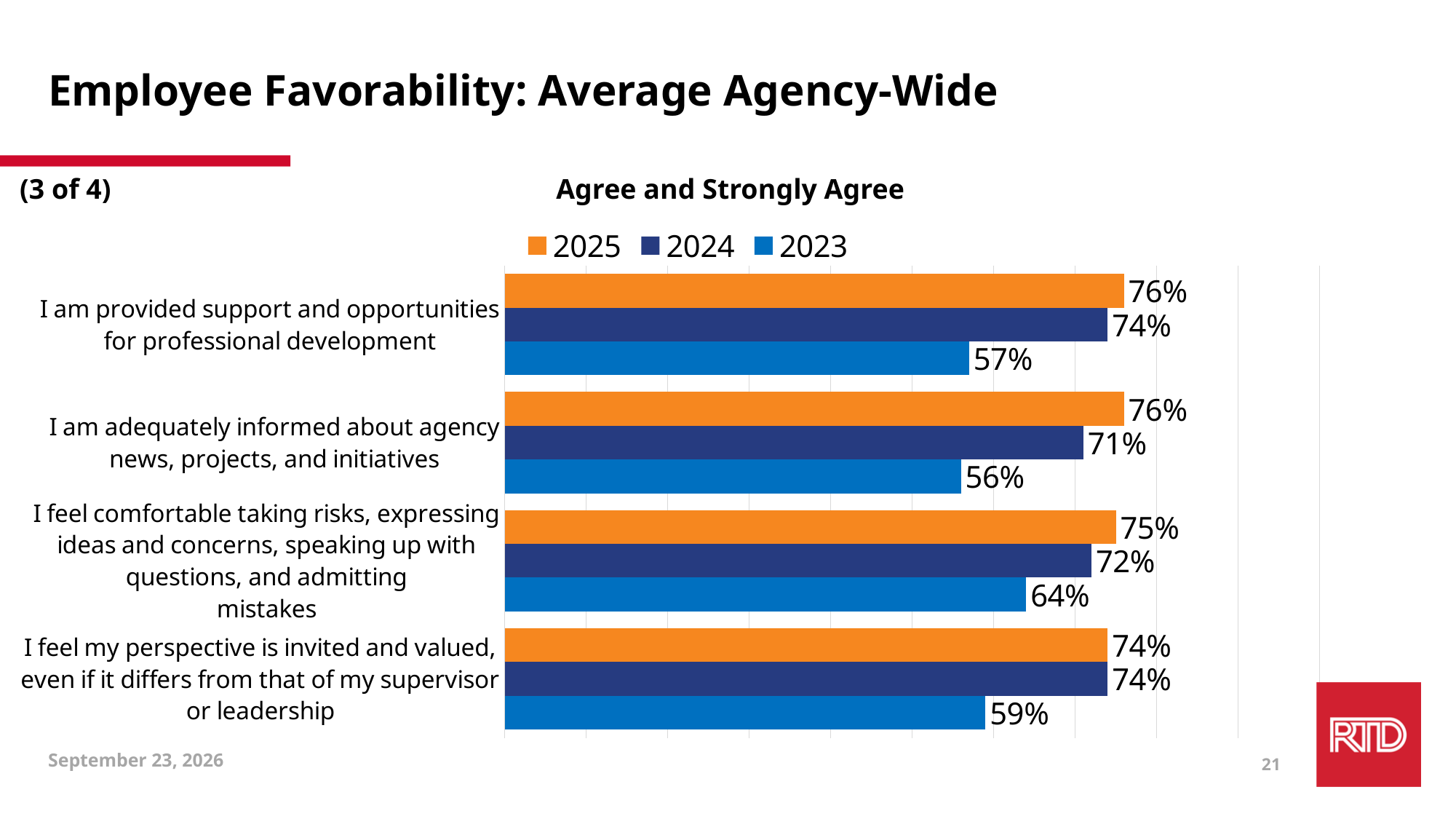
Which statement has the highest 2023 value? I feel comfortable taking risks, expressing ideas and concerns, speaking up with questions, and admitting mistakes What type of chart is shown on the slide? Bar chart For "I feel comfortable taking risks, expressing ideas and concerns, speaking up with questions, and admitting mistakes", which year has the larger value, 2025 or 2023? 2025 What is the 2023 value for "I am adequately informed about agency news, projects, and initiatives"? 56% What is the difference between the 2024 and 2023 values for "I am adequately informed about agency news, projects, and initiatives"? 15 percentage points What is the 2024 value for "I feel comfortable taking risks, expressing ideas and concerns, speaking up with questions, and admitting mistakes"? 72% What is the difference between the 2025 and 2023 values for "I am provided support and opportunities for professional development"? 19 percentage points How many statements (categories) are shown on the chart? 4 How many series does the legend list? 3 Which statement has the lowest 2023 value? I am adequately informed about agency news, projects, and initiatives What is the 2025 value for "I am provided support and opportunities for professional development"? 76% What is the 2023 value for "I feel my perspective is invited and valued, even if it differs from that of my supervisor or leadership"? 59%